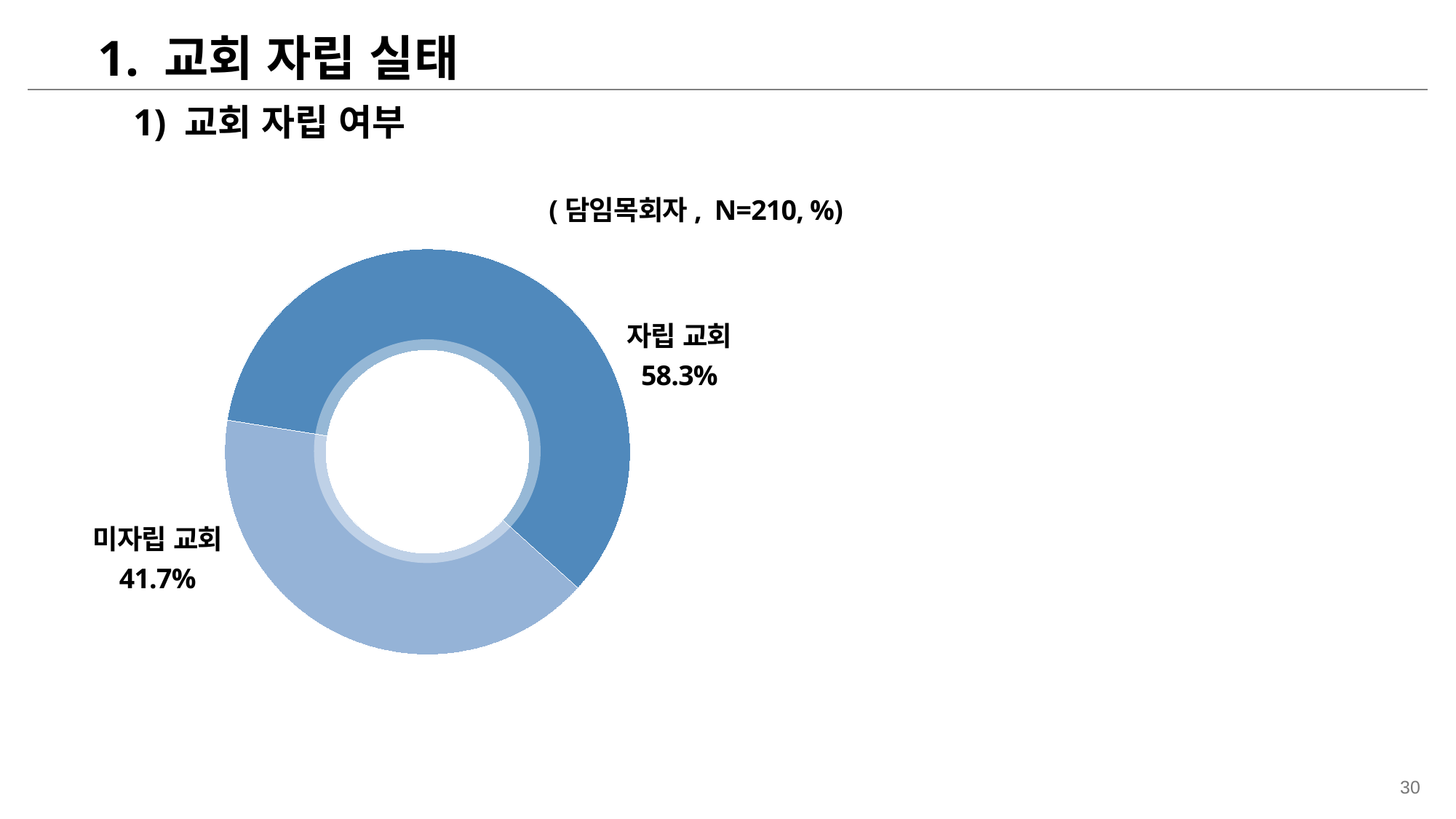
What is the difference between the shares of 자립 교회 and 미자립 교회? 16.6% What kind of chart is shown on the slide? Doughnut (pie) chart Which category has the smallest share? 미자립 교회 Which is larger, the share of 자립 교회 or 미자립 교회? 자립 교회 How many categories are shown in the chart? 2 Which category has the largest share? 자립 교회 What is the value for 미자립 교회? 41.7% What is the sample size (N) stated above the chart? 210 What respondent group is indicated in the note above the chart? 담임목회자 What is the total of the two shares shown in the chart? 100% What is the value for 자립 교회? 58.3%